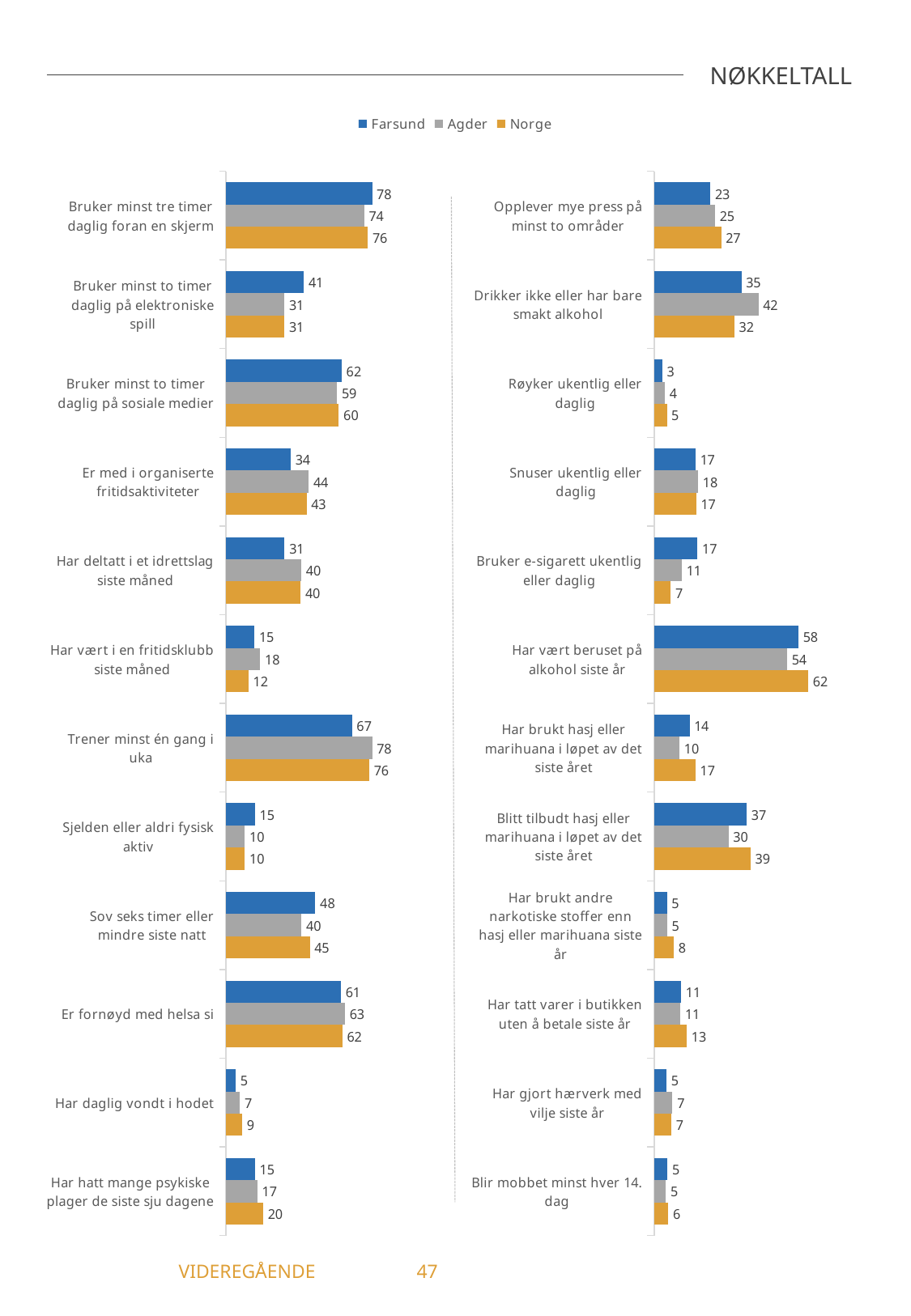
In the left chart, what is the difference between the Agder and Farsund values for 'Er med i organiserte fritidsaktiviteter'? 10 In the left chart, what is the Agder value for 'Trener minst én gang i uka'? 78 In the right chart, which is larger for 'Drikker ikke eller har bare smakt alkohol': the Agder value or the Norge value? Agder In the left chart, which category has the lowest Farsund value? Har daglig vondt i hodet In the right chart, what is the difference between the Farsund and Norge values for 'Bruker e-sigarett ukentlig eller daglig'? 10 In the right chart, which category has the highest Farsund value? Har vært beruset på alkohol siste år In the left chart, what is the Farsund value for 'Bruker minst tre timer daglig foran en skjerm'? 78 What kind of chart is used on this slide? Bar chart How many series does the legend list? 3 In the right chart, what is the Norge value for 'Har vært beruset på alkohol siste år'? 62 How many categories are shown in the left chart? 12 Which series is shown in orange in the legend? Norge